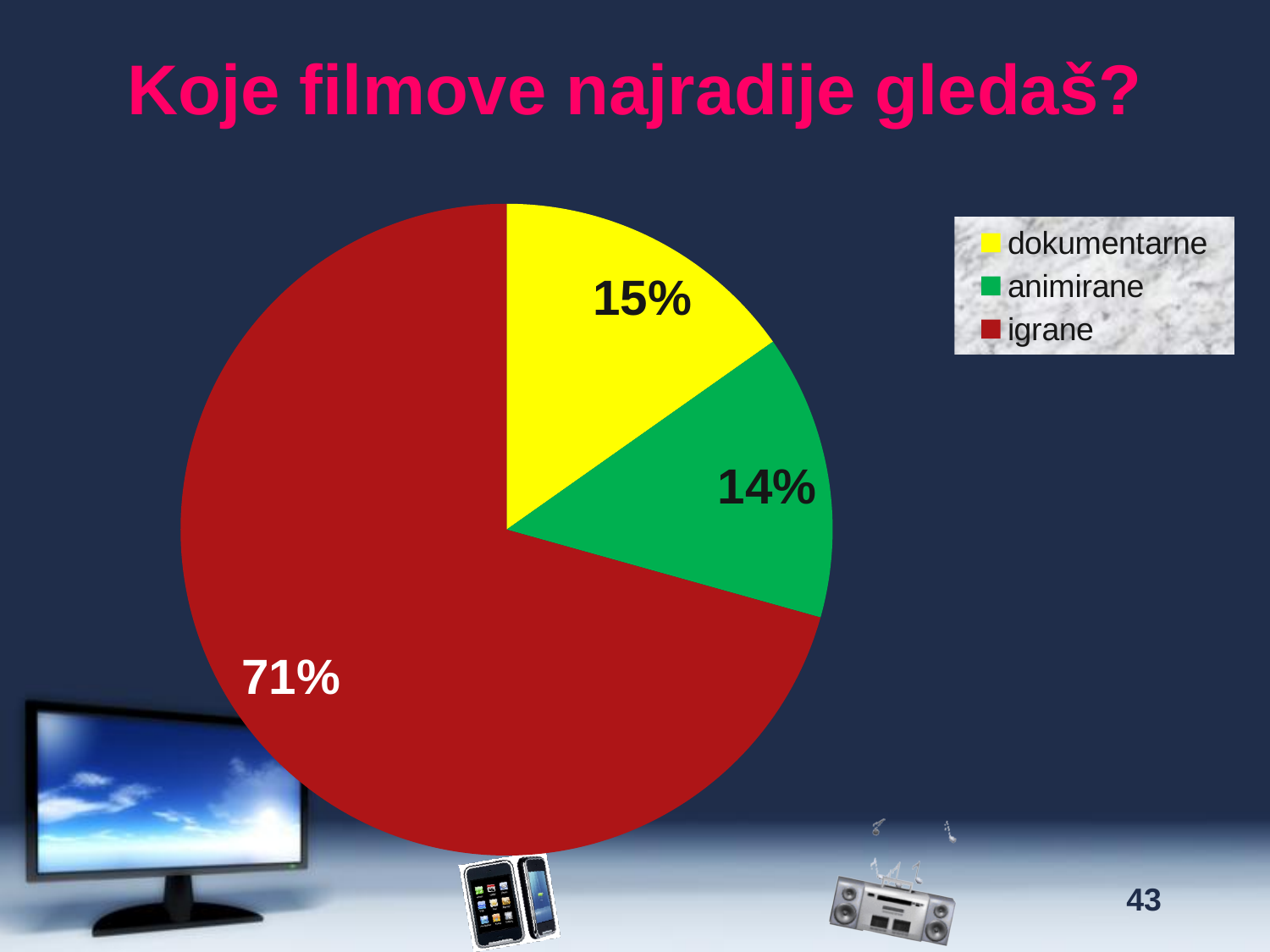
Which is larger, the share for igrane or the share for animirane? igrane What percentage of the pie is labelled for igrane? 71% What percentage of the pie is labelled for dokumentarne? 15% What is the difference in percentage points between igrane and dokumentarne? 56 What is the title of the chart on the slide? Koje filmove najradije gledaš? What percentage of the pie is labelled for animirane? 14% What type of chart is shown on the slide? pie chart Which category has the largest share of the pie? igrane What colour is the slice for animirane? green What is the difference in percentage points between dokumentarne and animirane? 1 How many categories does the pie chart show? 3 Which category has the smallest share of the pie? animirane